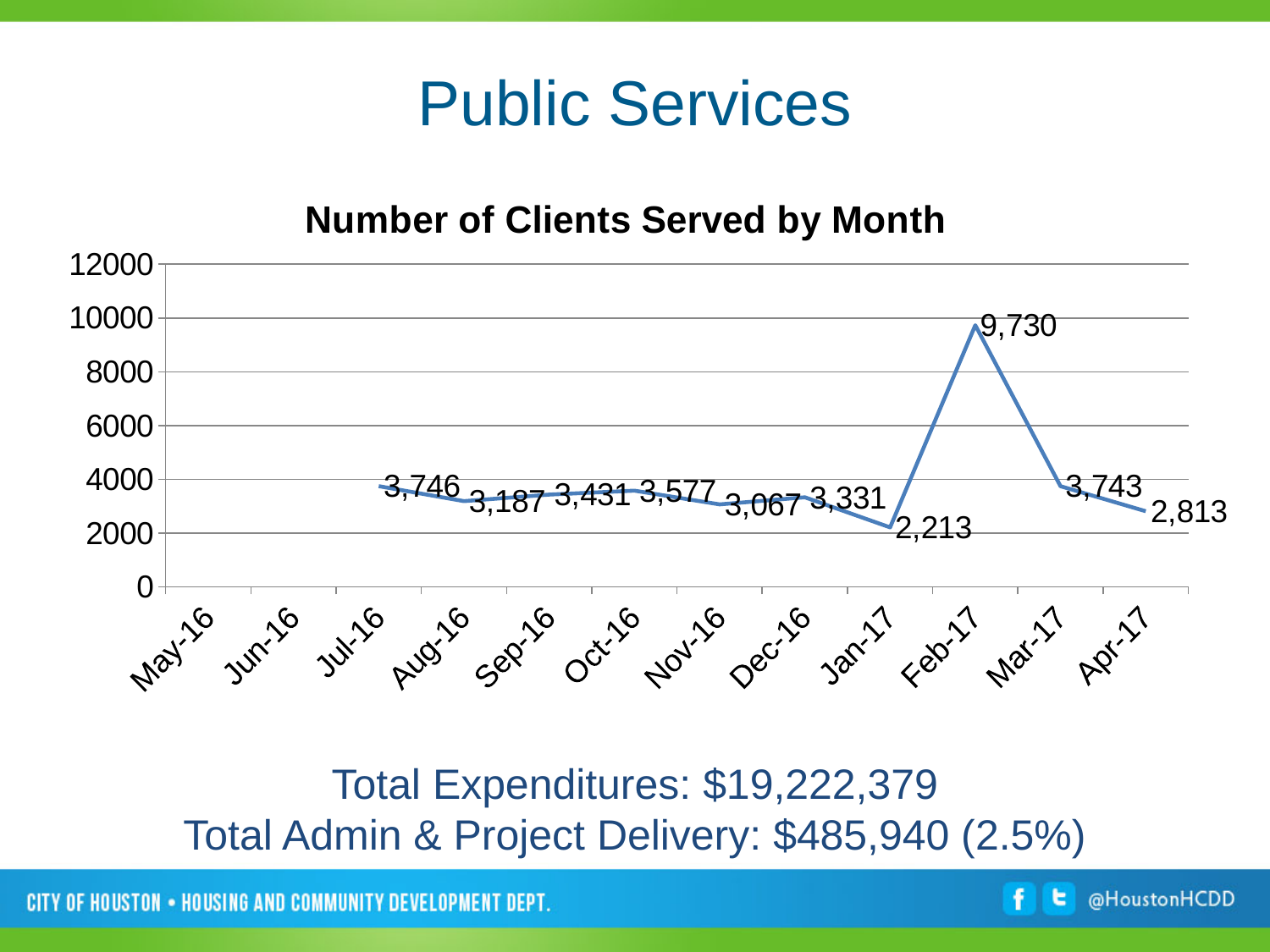
What is the title of the chart? Number of Clients Served by Month Is the value for Feb-17 greater or less than 8000? greater How many clients were served in Feb-17? 9,730 How many clients were served in Jan-17? 2,213 Which month has the lowest number of clients served? Jan-17 What is the value for Apr-17? 2,813 Which month has the highest number of clients served? Feb-17 What is the value for Oct-16? 3,577 What is the difference between the values for Feb-17 and Jan-17? 7,517 What type of chart is shown on the slide? line chart How many months have a plotted data point on the line? 10 Which month has a larger value, Oct-16 or Nov-16? Oct-16